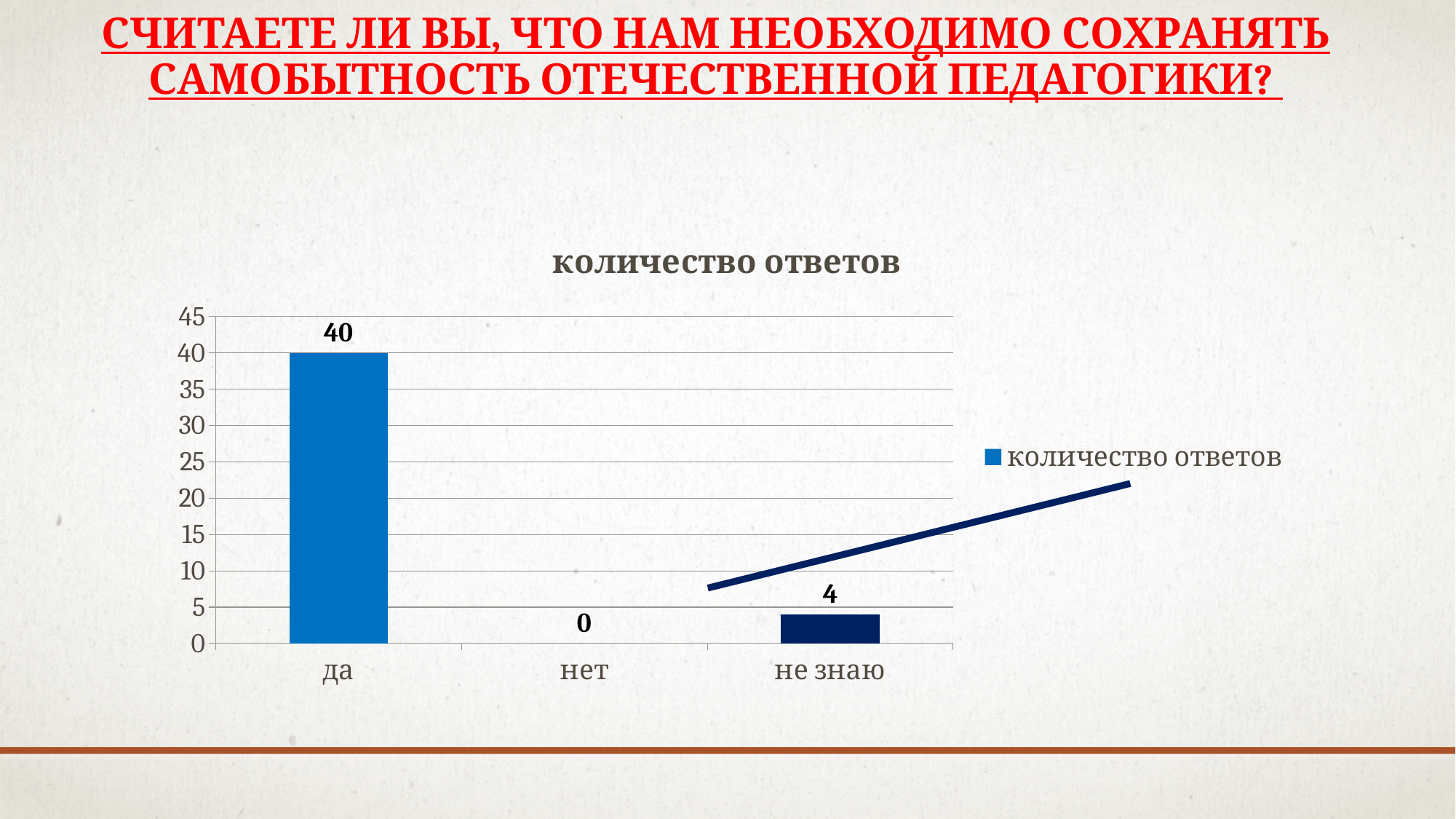
What is the value for "да"? 40 Is the value for "да" greater or less than 35? greater What is the value for "нет"? 0 How many series does the legend list? 1 Which category has the lowest value? нет Which is larger, the value for "не знаю" or the value for "нет"? не знаю How many categories are shown on the x axis? 3 What is the value for "не знаю"? 4 What is the title of the chart? количество ответов What is the difference between the values for "да" and "не знаю"? 36 What kind of chart is shown on the slide? bar chart Which category has the highest value? да